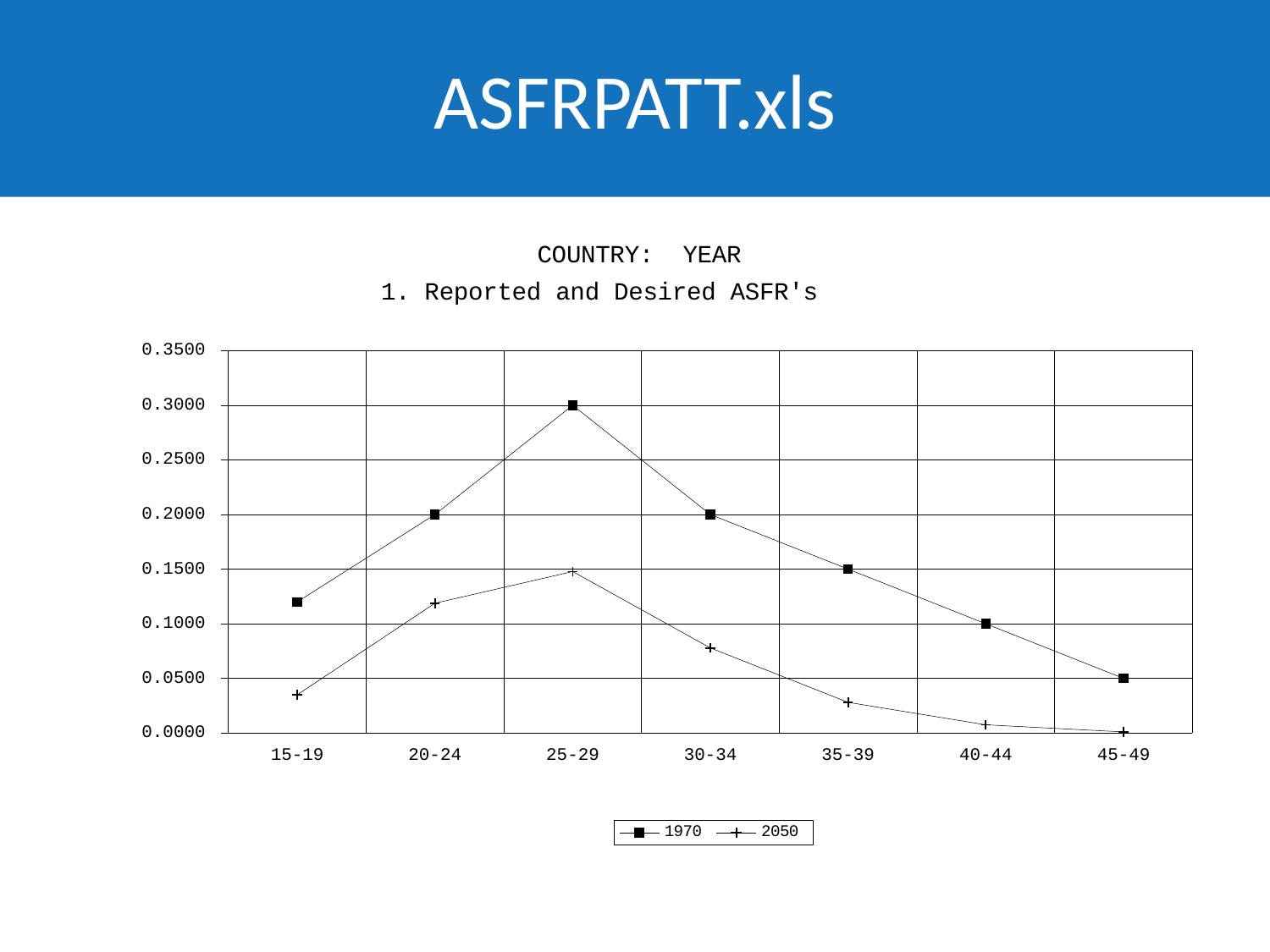
What is the value of the 1970 series for the 45-49 age group? 0.0500 For the 30-34 age group, which series has the larger value, 1970 or 2050? 1970 Which age group has the lowest value in the 1970 series? 45-49 What is the value of the 1970 series for the 40-44 age group? 0.1000 How many age-group categories are shown on the x axis? 7 Is the value of the 1970 series for the 15-19 age group greater or less than 0.1000? greater Is the value of the 2050 series for the 30-34 age group greater or less than 0.1000? less Which age group has the highest value in the 1970 series? 25-29 What is the value of the 1970 series for the 25-29 age group? 0.3000 How many series does the legend list? 2 What kind of chart is shown on the slide? line chart What is the difference between the 1970 values for the 25-29 and 45-49 age groups? 0.2500